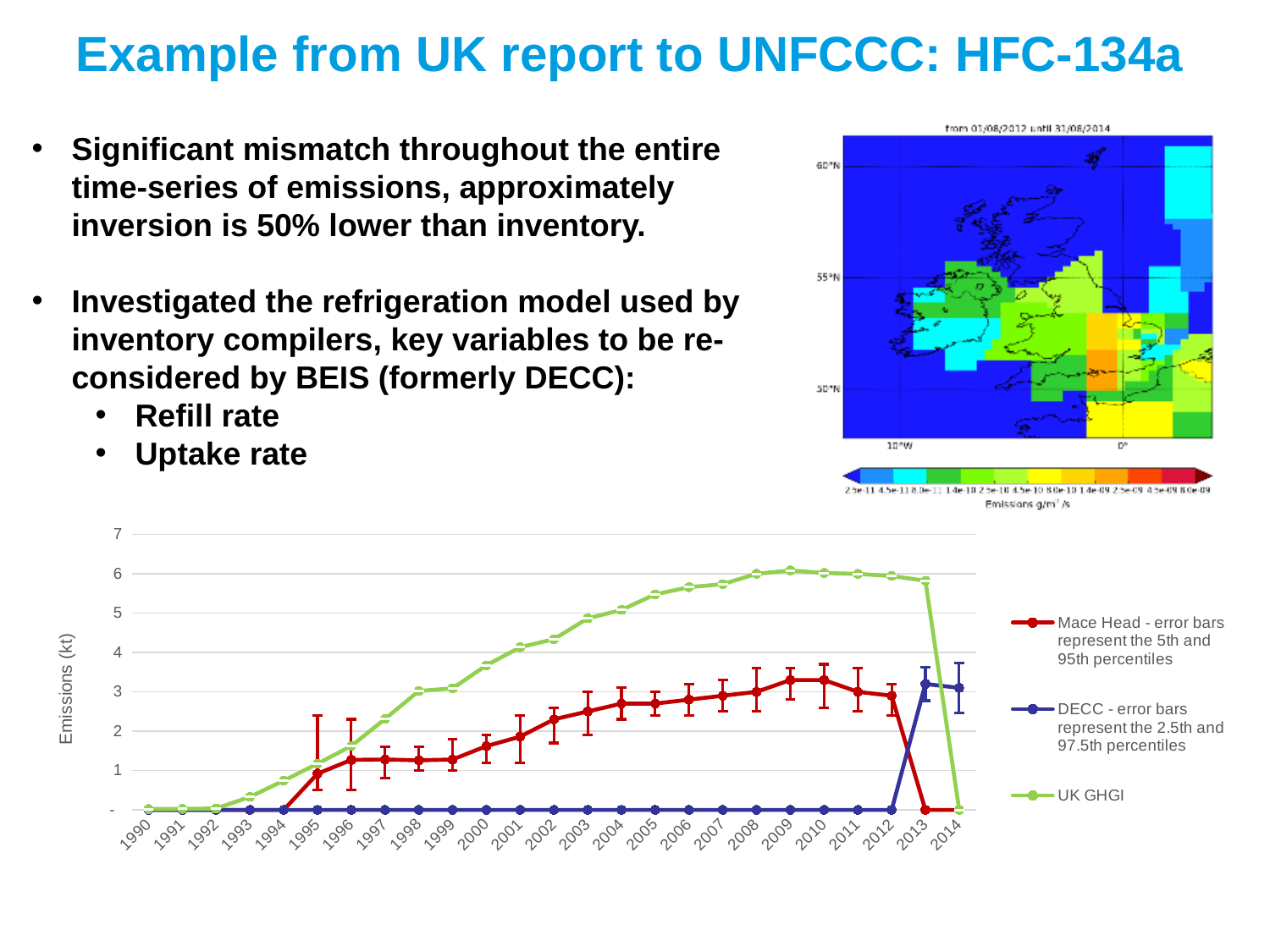
In the bottom line chart, do the UK GHGI values rise or fall from 1990 to 2009? rise In the bottom line chart, is the DECC value for 2013 greater or less than 2? greater In the bottom line chart, is the UK GHGI value for 2005 greater or less than 5? greater How many series does the legend of the bottom line chart list? 3 What is the y-axis label of the bottom line chart? Emissions (kt) What kind of chart is the chart at the bottom of the slide? line chart How many years are shown on the x axis of the bottom line chart? 25 In the bottom line chart, is the UK GHGI value for 2000 greater or less than 4? less In the bottom line chart, which series has the highest value in 2009? UK GHGI In the bottom line chart, which series has the higher value in 2005, UK GHGI or Mace Head? UK GHGI In the bottom line chart, which series has the higher value in 2013, DECC or Mace Head? DECC